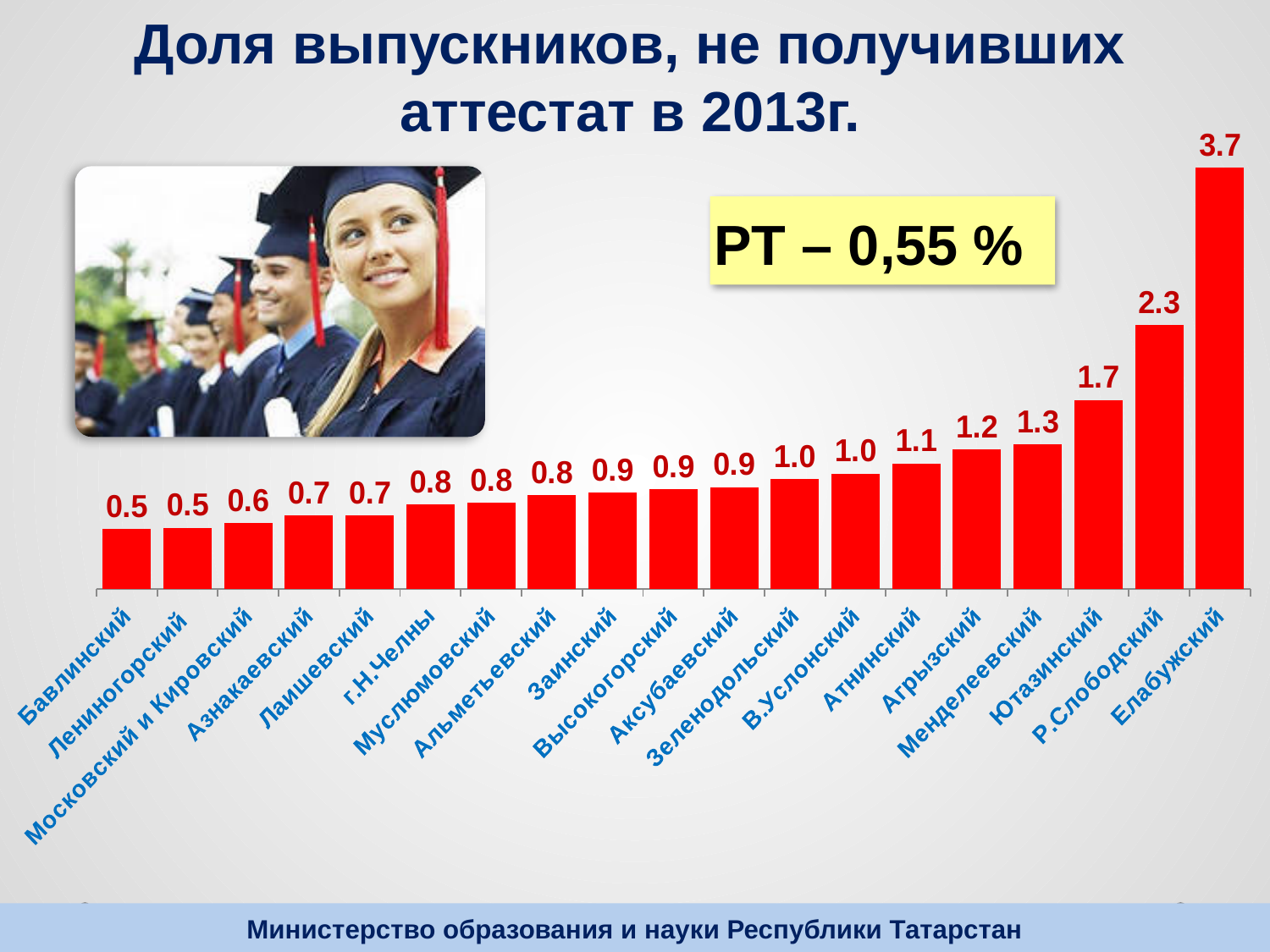
Do the values rise or fall from left to right along the x axis? Rise What is the value for г.Н.Челны? 0.8 What kind of chart is shown on the slide? Bar chart What value for РТ is shown in the yellow box on the slide? 0,55 % What is the value for Елабужский? 3.7 How many categories are shown in the chart? 19 What is the difference between the values for Менделеевский and Бавлинский? 0.8 Which is larger, the value for Агрызский or the value for Азнакаевский? Агрызский What is the value for Атнинский? 1.1 What is the value for Ютазинский? 1.7 What is the difference between the values for Елабужский and Р.Слободский? 1.4 Which category has the highest value? Елабужский